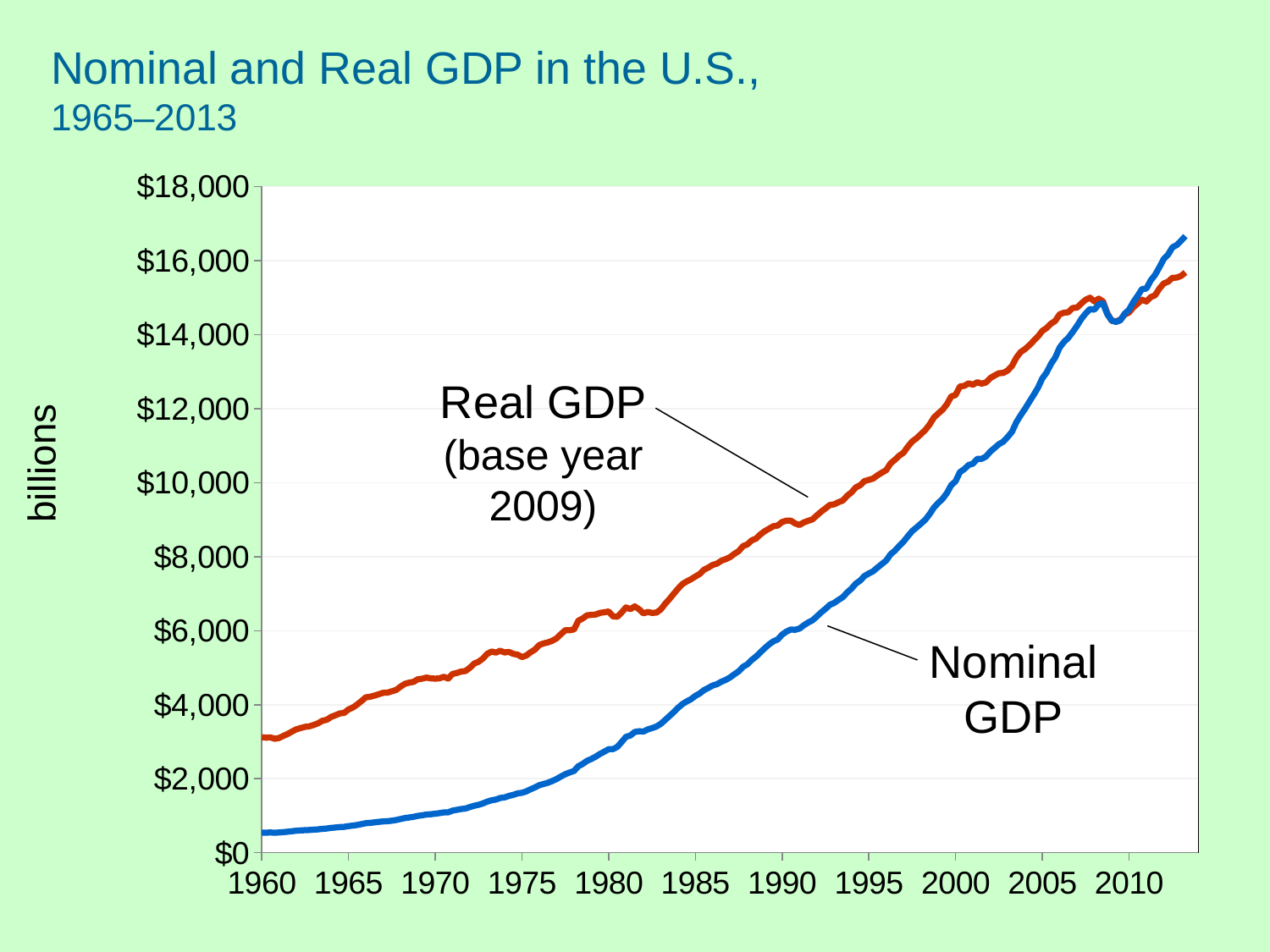
How many series are plotted on the chart? 2 What kind of chart is shown on the slide? line chart Is the value of Real GDP in 1960 greater or less than $2,000? greater Is the value of Real GDP in 1990 greater or less than $8,000? greater At the end of the series in 2013, which is higher: Nominal GDP or Real GDP? Nominal GDP Is the value of Nominal GDP in 1960 greater or less than $2,000? less In 1960, which is higher: Real GDP or Nominal GDP? Real GDP What is the title of the chart on the slide? Nominal and Real GDP in the U.S., 1965–2013 In 1990, which is higher: Real GDP or Nominal GDP? Real GDP What is the label on the vertical axis of the chart? billions Does Nominal GDP generally rise or fall from 1960 to 2013? rise